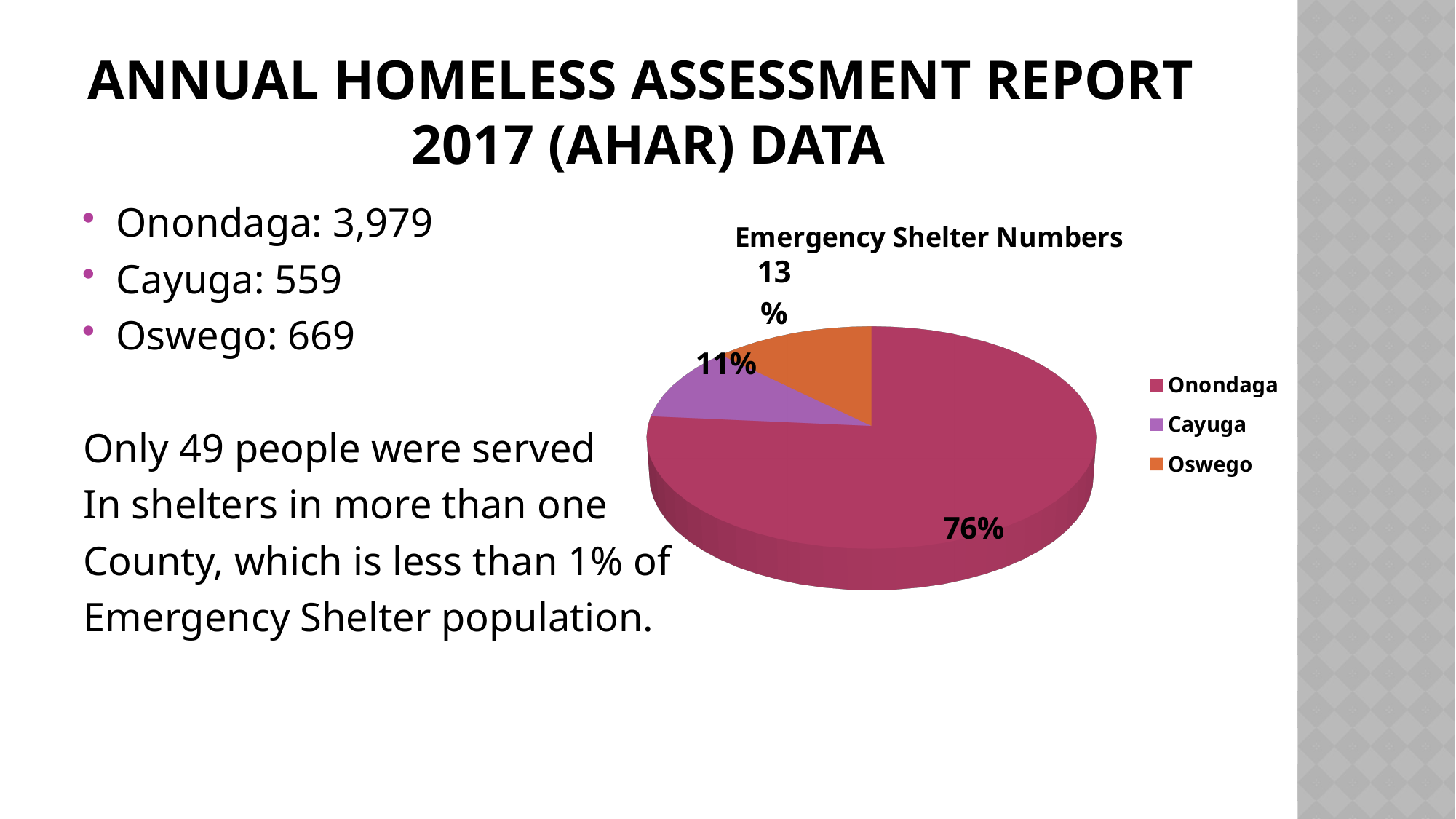
How many entries does the legend list? 3 What share of the pie does Cayuga represent? 11% What colour is the Oswego slice in the pie chart? orange What is the difference in percentage points between the Onondaga slice and the Oswego slice? 63 How many slices does the pie chart have? 3 Which county has the largest slice of the pie? Onondaga Which county has the smallest slice of the pie? Cayuga What type of chart is shown on the slide? pie chart What is the title of the pie chart? Emergency Shelter Numbers Which slice is larger, Oswego or Cayuga? Oswego What share of the pie does Onondaga represent? 76% What share of the pie does Oswego represent? 13%